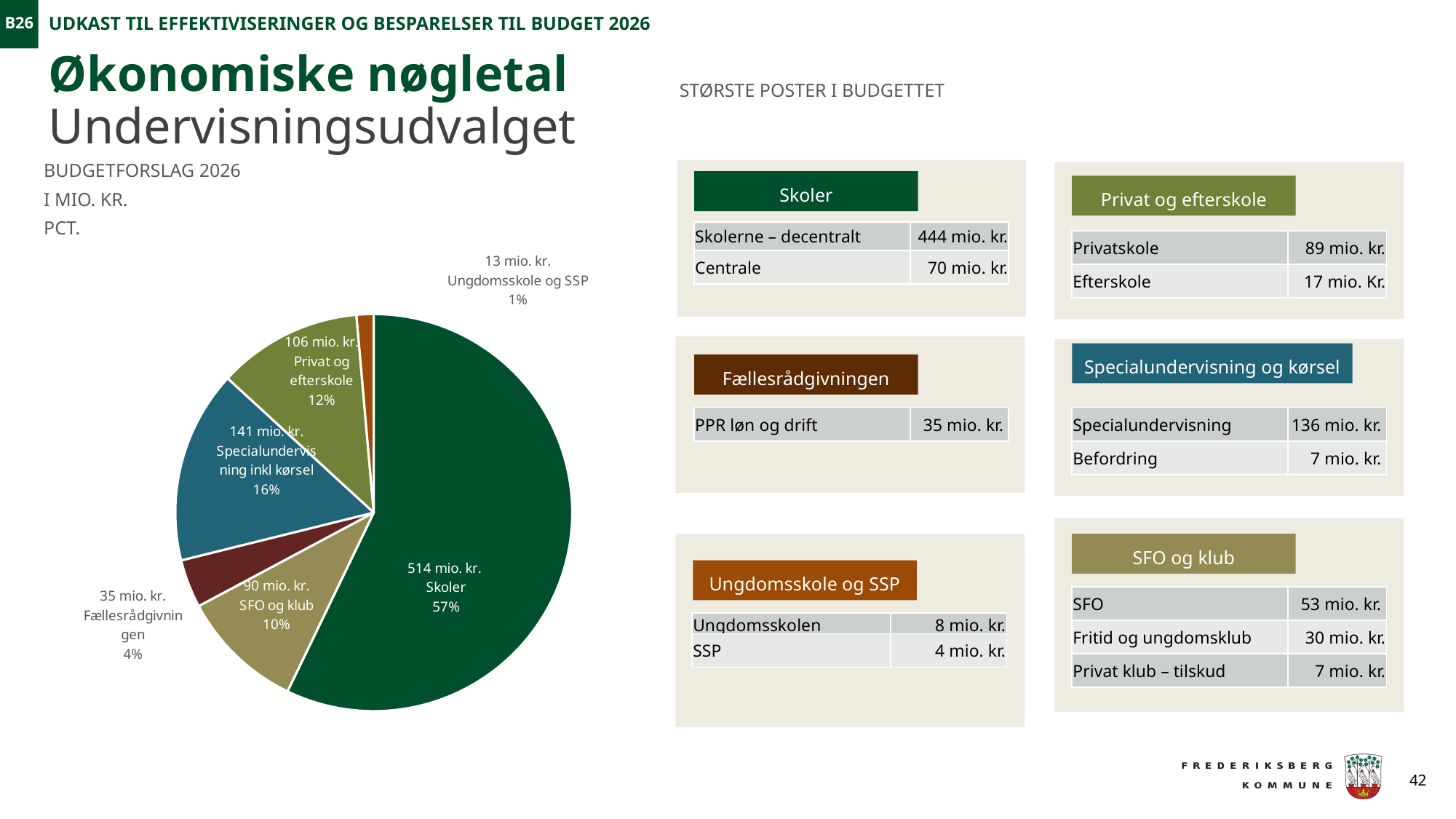
What share of the pie does Privat og efterskole represent? 12% Which is larger in the pie chart, SFO og klub or Fællesrådgivningen? SFO og klub What share of the pie does Fællesrådgivningen represent? 4% Which category has the smallest slice in the pie chart? Ungdomsskole og SSP What kind of chart is shown on the slide? Pie chart What is the difference between the values for Specialundervisning inkl kørsel and Privat og efterskole in the pie chart? 35 mio. kr. How many slices does the pie chart have? 6 What is the value for SFO og klub in the pie chart? 90 mio. kr. What is the value for Specialundervisning inkl kørsel in the pie chart? 141 mio. kr. Which category has the largest slice in the pie chart? Skoler What is the value for Ungdomsskole og SSP in the pie chart? 13 mio. kr. What is the value for Skoler in the pie chart? 514 mio. kr.